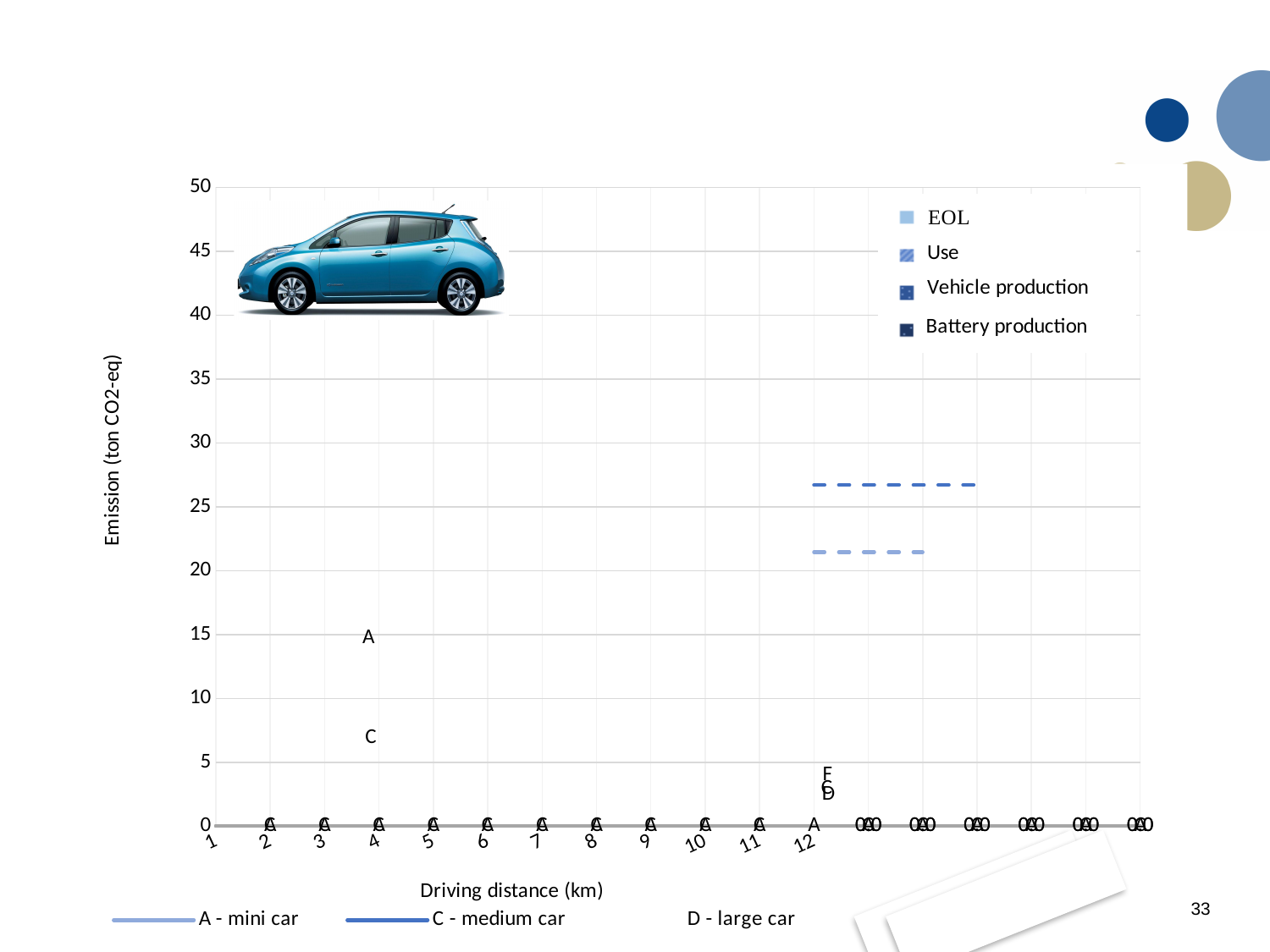
Is the lower dashed horizontal line on the chart greater or less than 20 on the vertical axis? greater What are the four entries in the upper-right legend of the chart? EOL, Use, Vehicle production, Battery production Is the upper dashed horizontal line on the chart greater or less than 25 on the vertical axis? greater What is the title of the vertical axis of the chart? Emission (ton CO2-eq) According to the legend below the chart, what type of car does the label C stand for? medium car Is the lower dashed horizontal line on the chart greater or less than 25 on the vertical axis? less How many entries does the legend in the upper right of the chart list? 4 Which of the two dashed horizontal lines on the chart is higher, the longer one or the shorter one? the longer one What is the highest value shown on the vertical axis of the chart? 50 According to the legend below the chart, what type of car does the label D stand for? large car What is the title of the horizontal axis of the chart? Driving distance (km)